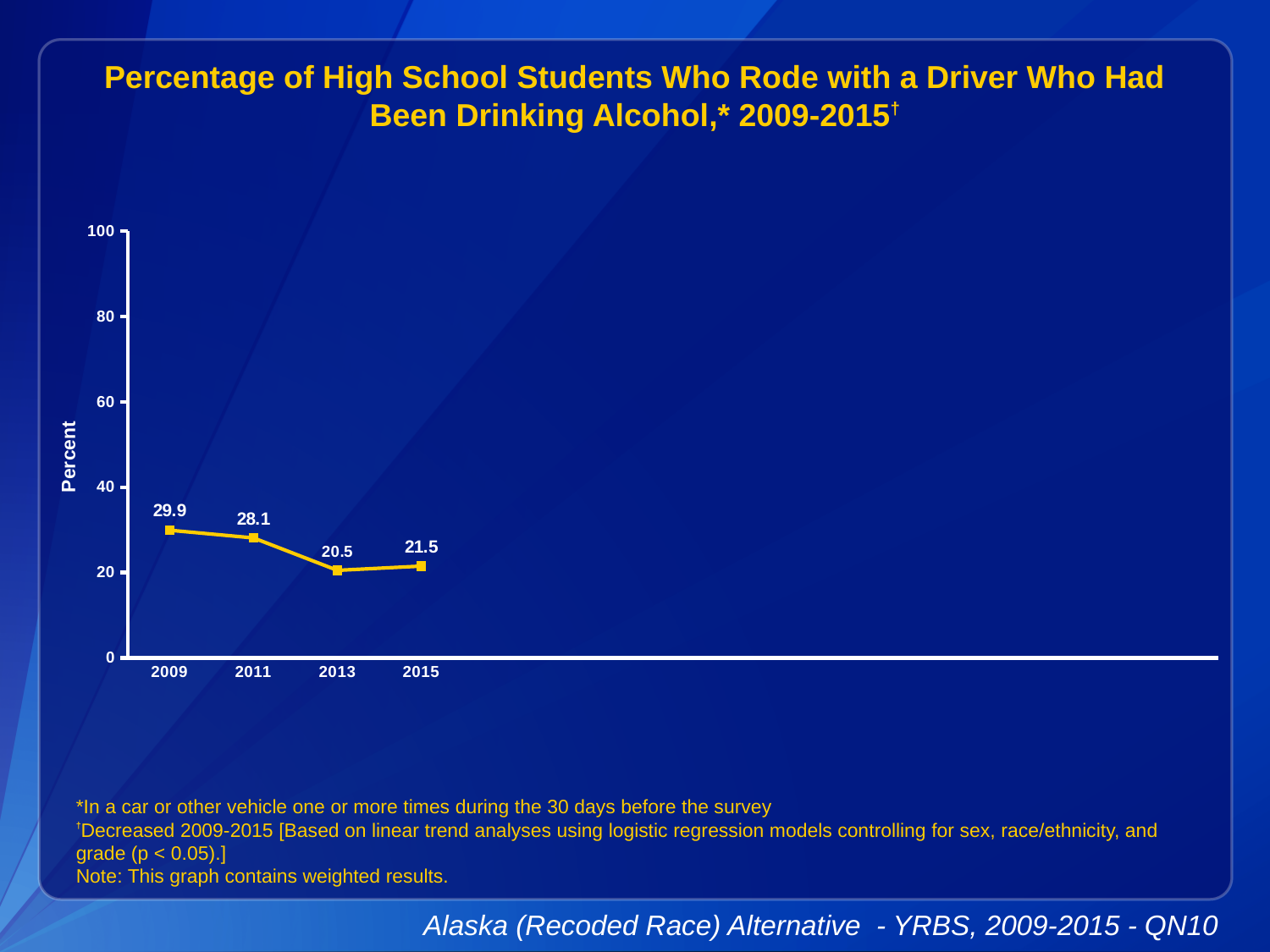
Which is larger, the value for 2011 or the value for 2015? 2011 What is the value plotted for 2015? 21.5 What is the difference between the 2009 value and the 2015 value? 8.4 How many years are plotted on the chart? 4 What kind of chart is shown on the slide? line chart What is the difference between the 2011 value and the 2013 value? 7.6 Is the value for 2009 greater or less than 40? less Which year has the lowest percentage? 2013 What is the label on the y axis? Percent What percentage of high school students rode with a driver who had been drinking alcohol in 2009? 29.9 Which year has the highest percentage? 2009 What is the value plotted for 2013? 20.5